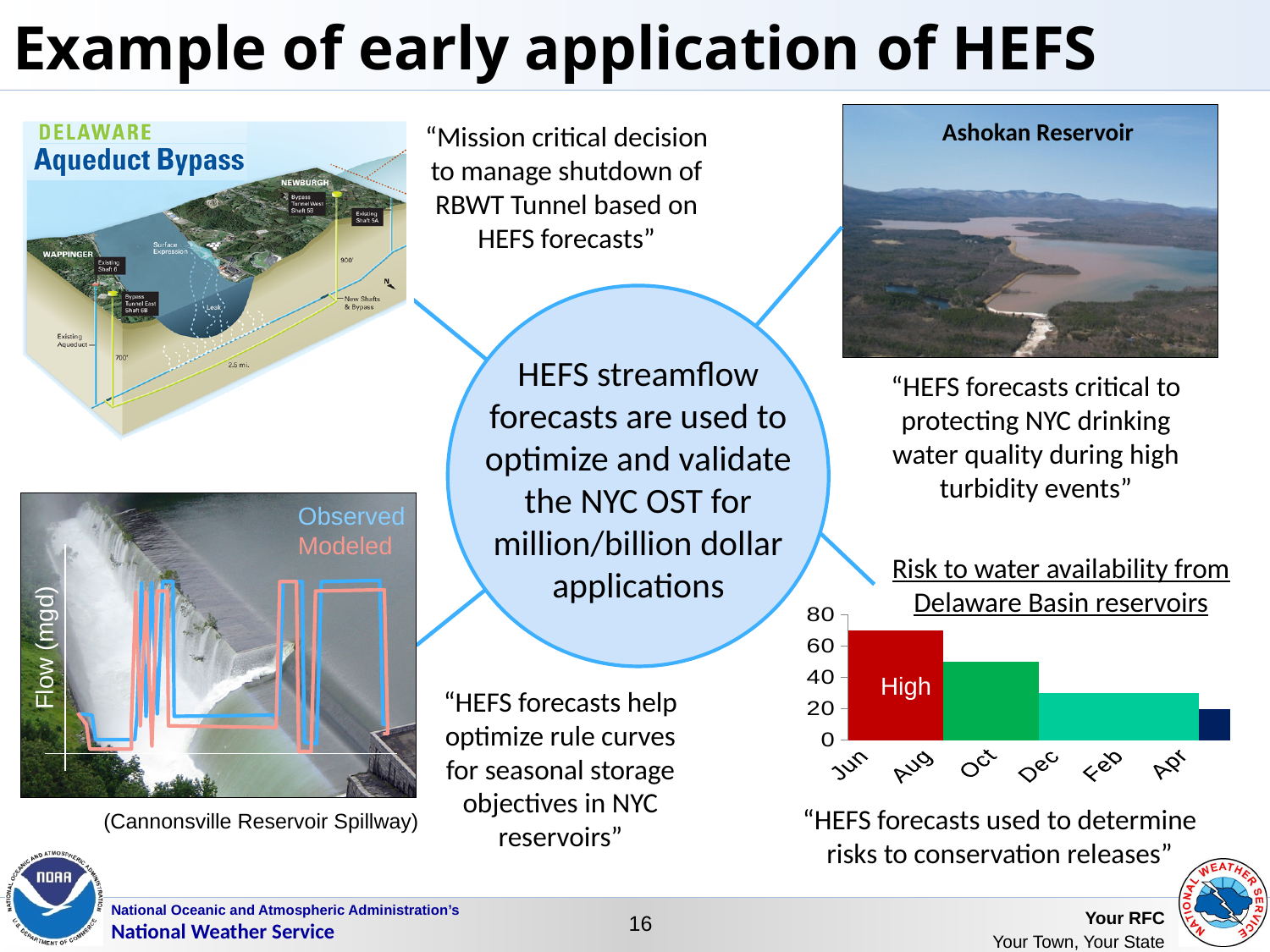
In the 'Risk to water availability from Delaware Basin reservoirs' chart, is the value for Apr greater or less than 40? less What kind of chart is 'Risk to water availability from Delaware Basin reservoirs'? bar chart What text label is printed inside the red bar of the 'Risk to water availability from Delaware Basin reservoirs' chart? High In the 'Risk to water availability from Delaware Basin reservoirs' chart, do the values rise or fall from Jun to Apr? fall In the 'Risk to water availability from Delaware Basin reservoirs' chart, is the value for Aug greater or less than 60? greater In the 'Risk to water availability from Delaware Basin reservoirs' chart, which is larger, the value for Jun or the value for Apr? Jun In the 'Risk to water availability from Delaware Basin reservoirs' chart, is the value for Jun greater or less than 60? greater How many month labels are on the x axis of the 'Risk to water availability from Delaware Basin reservoirs' chart? 6 In the Flow (mgd) chart over the Cannonsville Reservoir Spillway photo, how many series does the legend list? 2